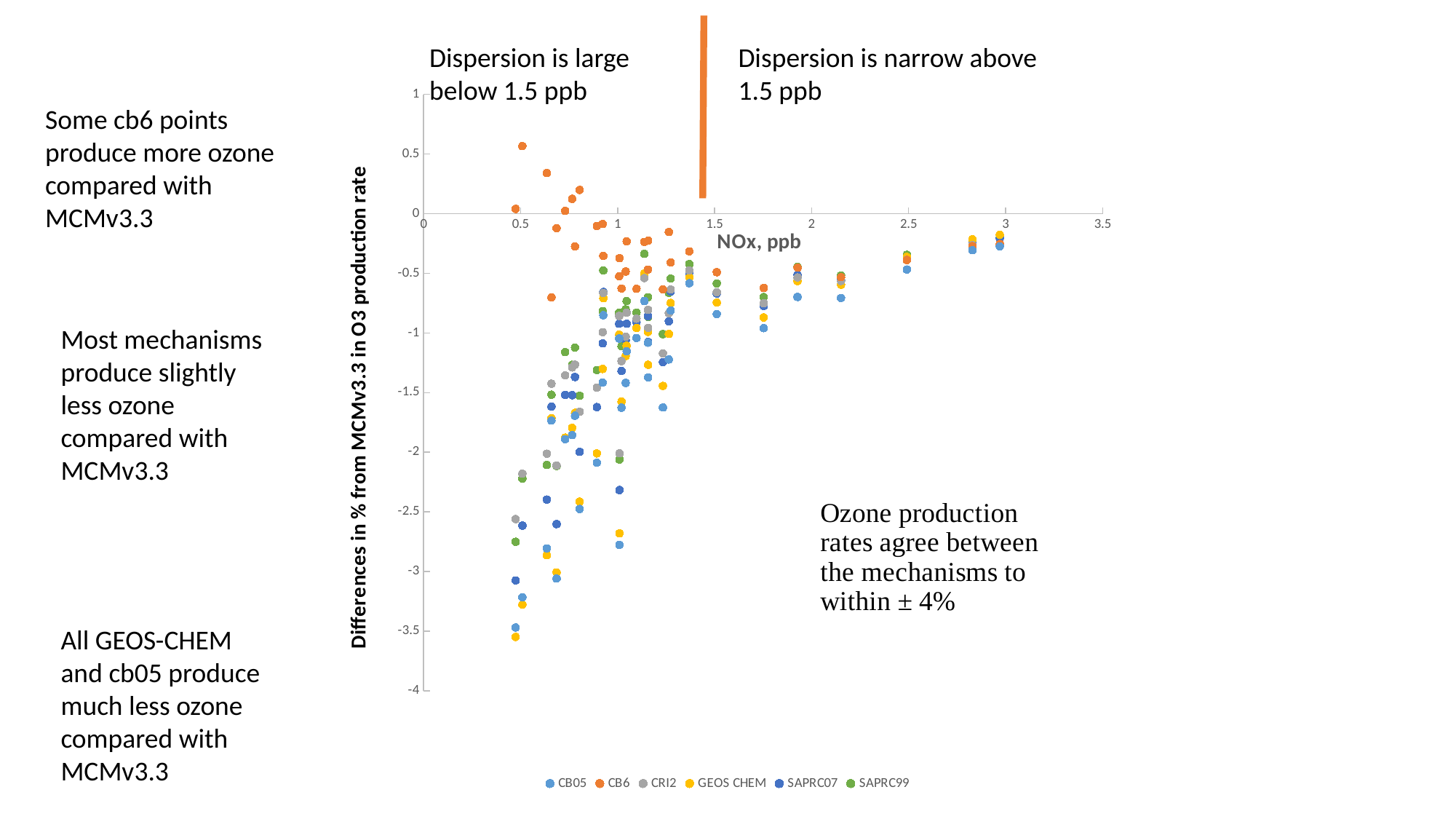
Is the lowest plotted point on the chart greater or less than -3? less What kind of chart is shown on the slide? Scatter chart Which series has the highest plotted point on the chart? CB6 Are the CB6 points near NOx = 3 greater or less than -0.5? greater Do the differences in O3 production rate generally rise or fall as NOx increases along the x axis? rise Which series has points plotted above 0 on the y axis? CB6 Is the highest CB6 point greater or less than 0 on the y axis? greater How many series does the legend list? 6 Is the spread of points wider below or above 1.5 ppb NOx? below Which series are listed in the legend? CB05, CB6, CRI2, GEOS CHEM, SAPRC07, SAPRC99 What is the label of the x axis? NOx, ppb